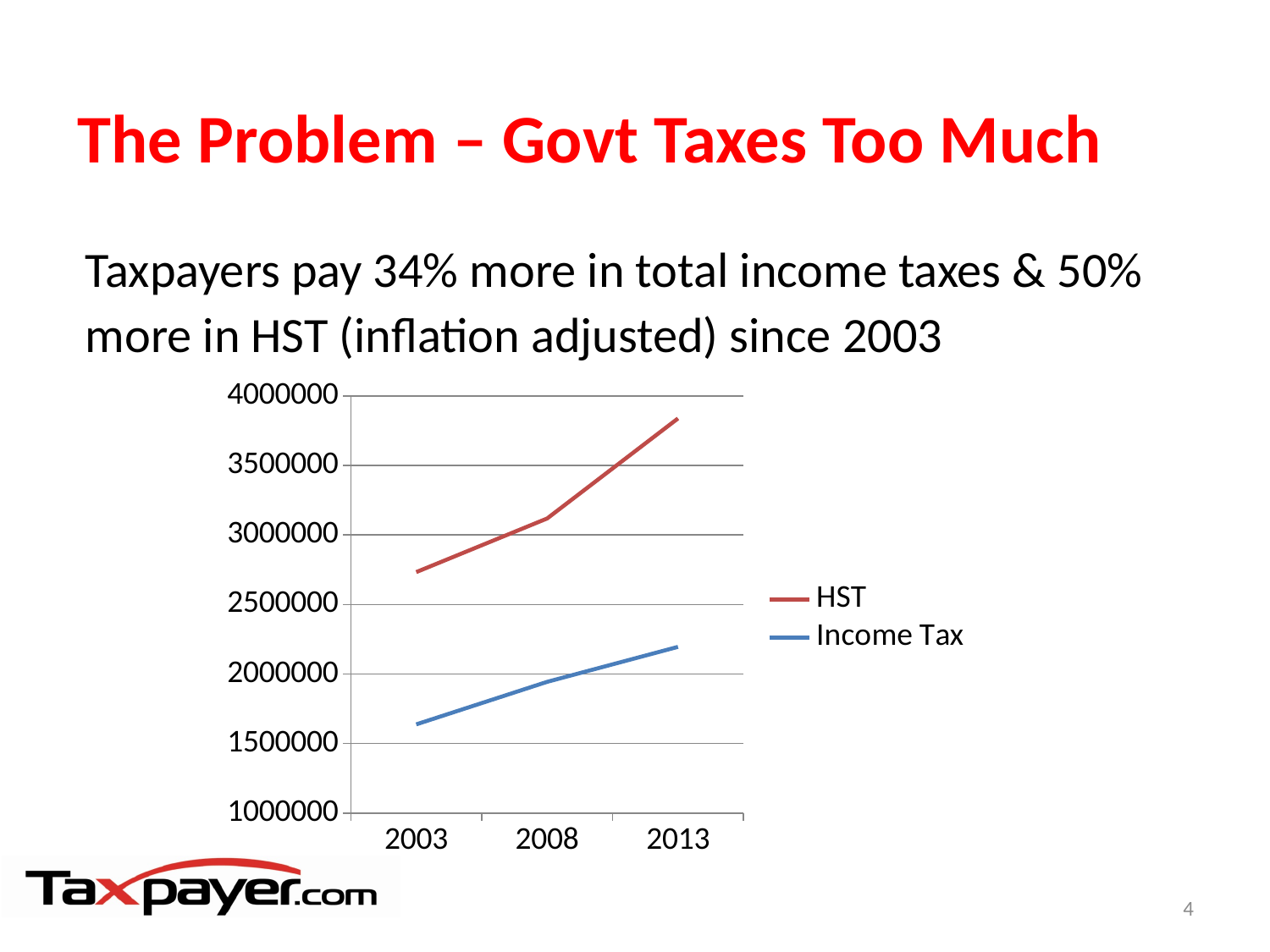
Does the Income Tax line rise or fall from 2003 to 2013? rise In which year is the HST value highest? 2013 Does the HST line rise or fall from 2003 to 2013? rise What kind of chart is shown on the slide? line chart How many series does the chart's legend list? 2 How many years are plotted along the x axis of the chart? 3 Is the Income Tax value for 2003 greater or less than 2000000? less Which series is plotted with the red line? HST What are the two series named in the chart's legend? HST and Income Tax In which year is the Income Tax value lowest? 2003